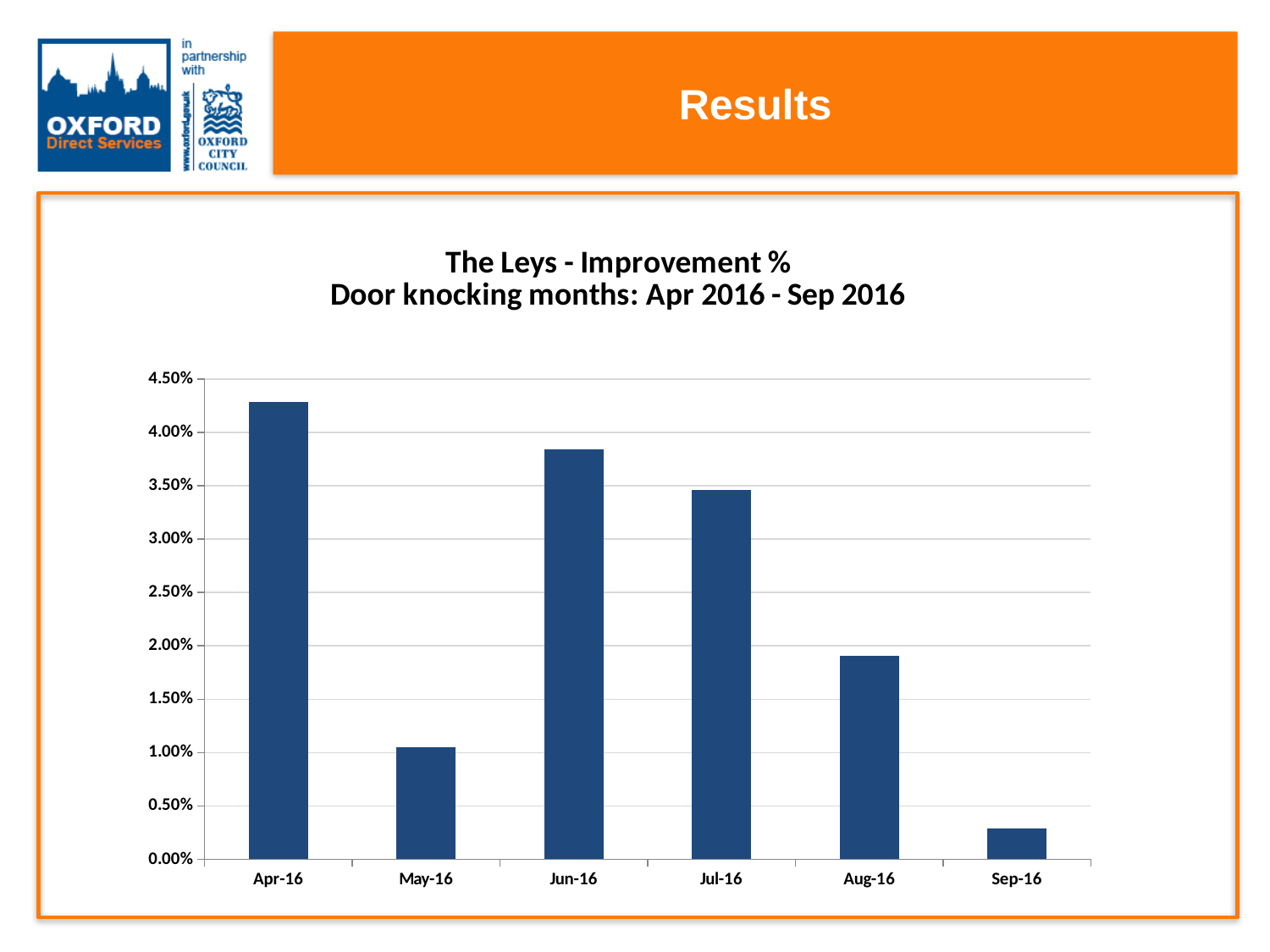
What is the title of the chart? The Leys - Improvement % Door knocking months: Apr 2016 - Sep 2016 Which is larger, the value for Jun-16 or the value for Jul-16? Jun-16 How many months are plotted on the chart? 6 Is the value for Jun-16 greater or less than 3.50%? greater Which is larger, the value for May-16 or the value for Aug-16? Aug-16 Which month has the lowest improvement percentage? Sep-16 Is the value for Apr-16 greater or less than 4.00%? greater Is the value for May-16 greater or less than 1.50%? less What kind of chart is shown on the slide? bar chart Which month has the highest improvement percentage? Apr-16